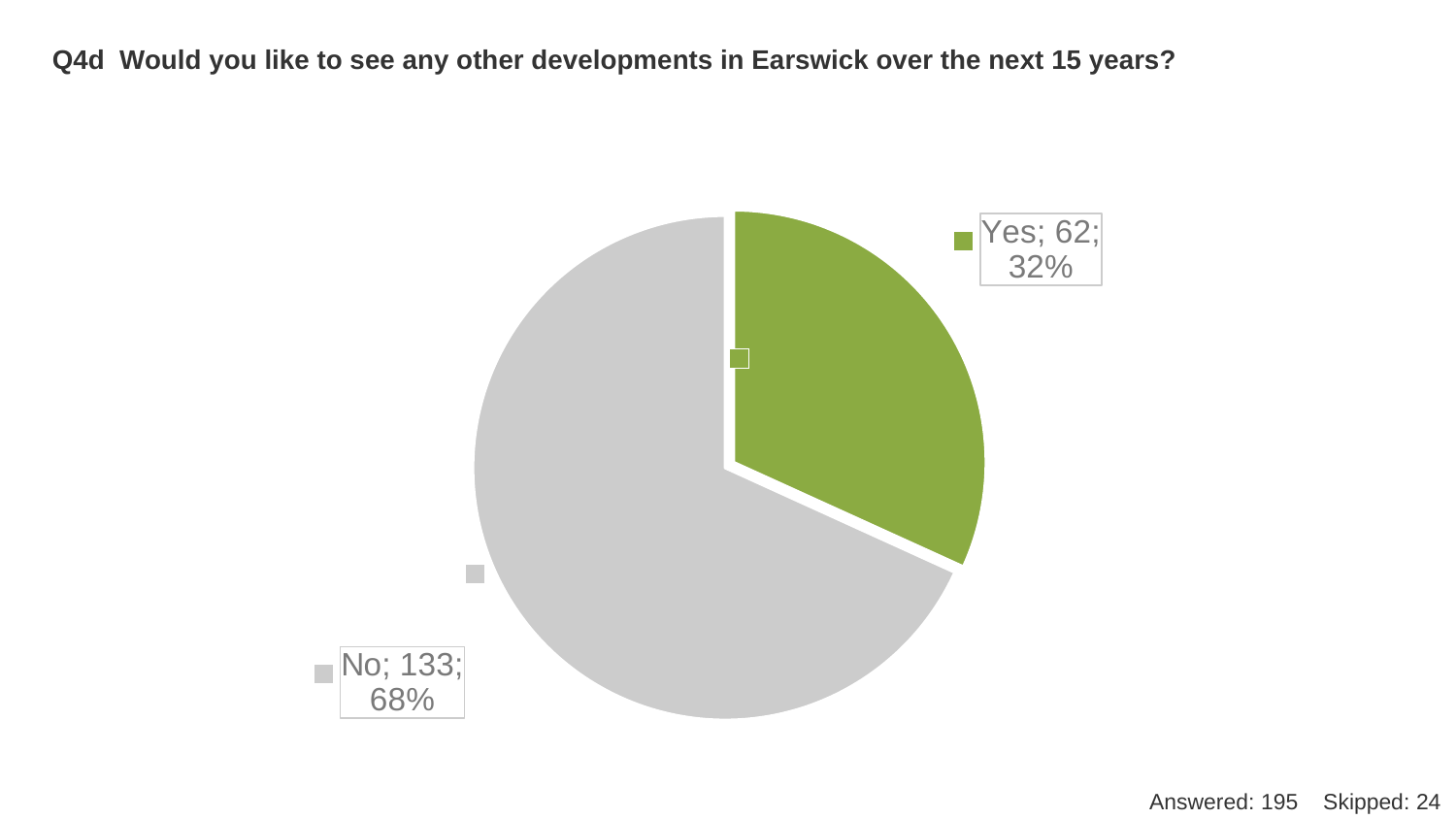
Which response has the smaller slice of the pie? Yes Which response has the larger slice of the pie? No How many slices does the pie chart have? 2 What percentage of respondents answered "No"? 68% Which is larger, the count for "Yes" or the count for "No"? No What colour is the "Yes" slice? green What kind of chart is shown on the slide? pie chart How many respondents answered "No"? 133 How many people answered the question according to the note on the slide? 195 How many more respondents answered "No" than "Yes"? 71 What percentage of respondents answered "Yes"? 32% How many respondents answered "Yes"? 62